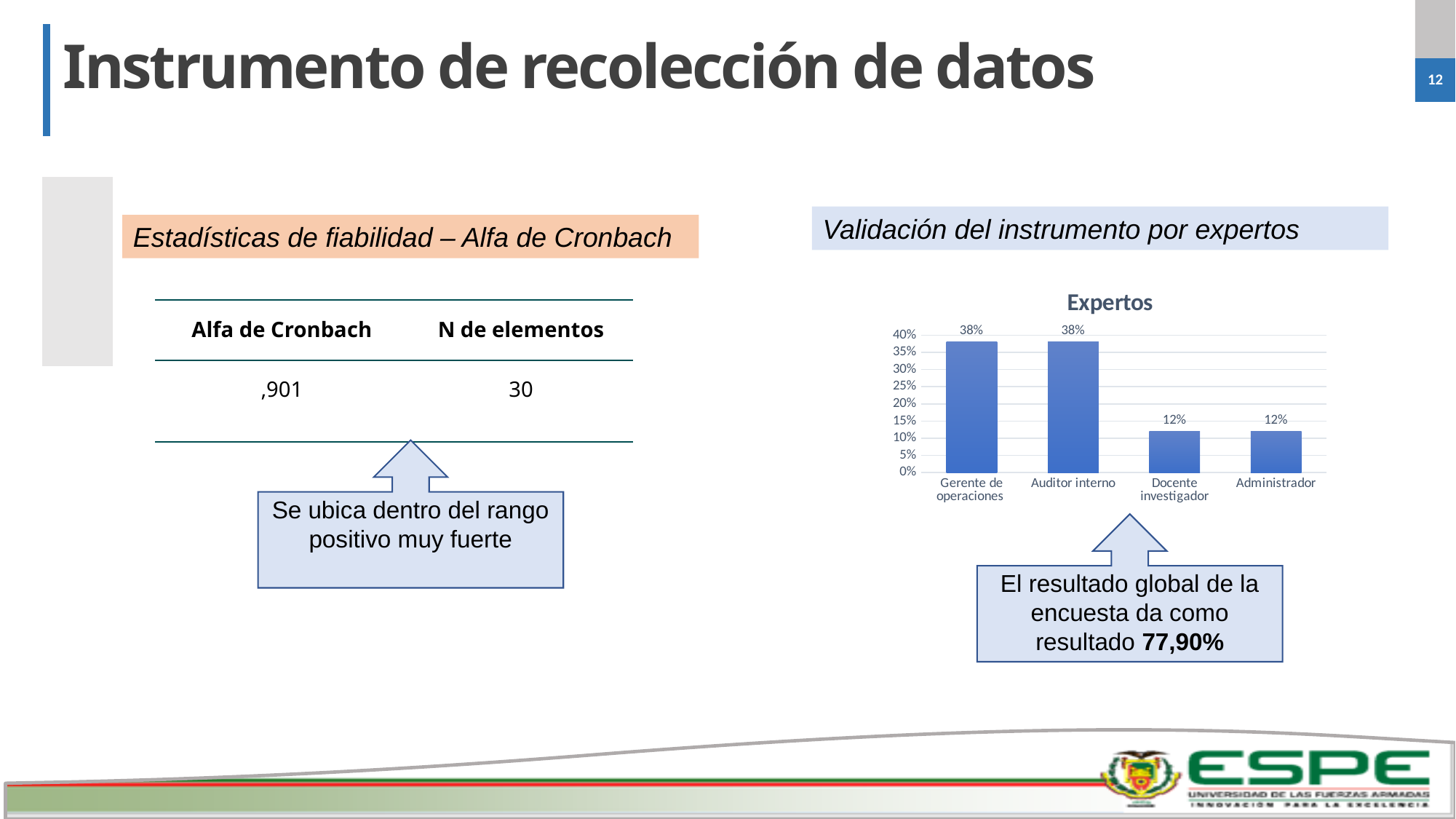
What is the difference between the values for Auditor interno and Docente investigador in the Expertos chart? 26% Is the value for Auditor interno in the Expertos chart greater or less than 30%? greater Is the value for Docente investigador in the Expertos chart greater or less than 20%? less What is the value for Administrador in the Expertos chart? 12% Which is larger in the Expertos chart, Gerente de operaciones or Administrador? Gerente de operaciones What is the title of the chart on the slide? Expertos What is the value for Auditor interno in the Expertos chart? 38% What is the value for Docente investigador in the Expertos chart? 12% What is the value for Gerente de operaciones in the Expertos chart? 38% What kind of chart is the Expertos chart? bar chart What is the highest value shown on the y axis of the Expertos chart? 40% How many categories are shown in the Expertos chart? 4